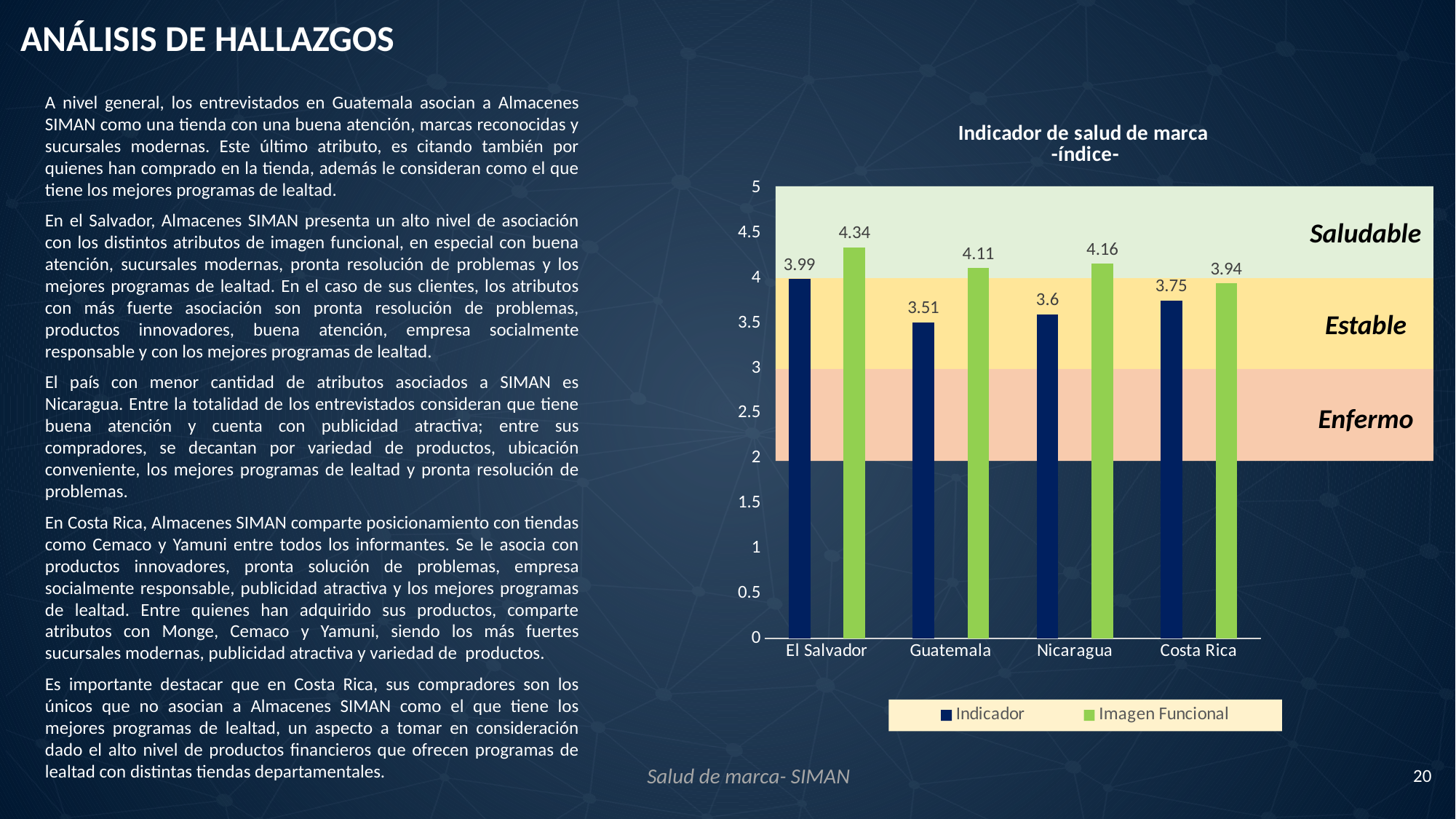
Which country has the highest Imagen Funcional value? El Salvador How many series does the chart legend list? 2 What kind of chart is shown on the slide? bar chart What is the difference between the Imagen Funcional and Indicador values for Nicaragua? 0.56 What is the Indicador value for Costa Rica? 3.75 Is the Indicador value for Guatemala greater or less than 4? less How many countries are shown on the x axis of the chart? 4 Which country has the lowest Indicador value? Guatemala Which is larger for Costa Rica, the Indicador value or the Imagen Funcional value? Imagen Funcional What is the Indicador value for El Salvador? 3.99 What is the Imagen Funcional value for Guatemala? 4.11 What is the title of the chart? Indicador de salud de marca -índice-